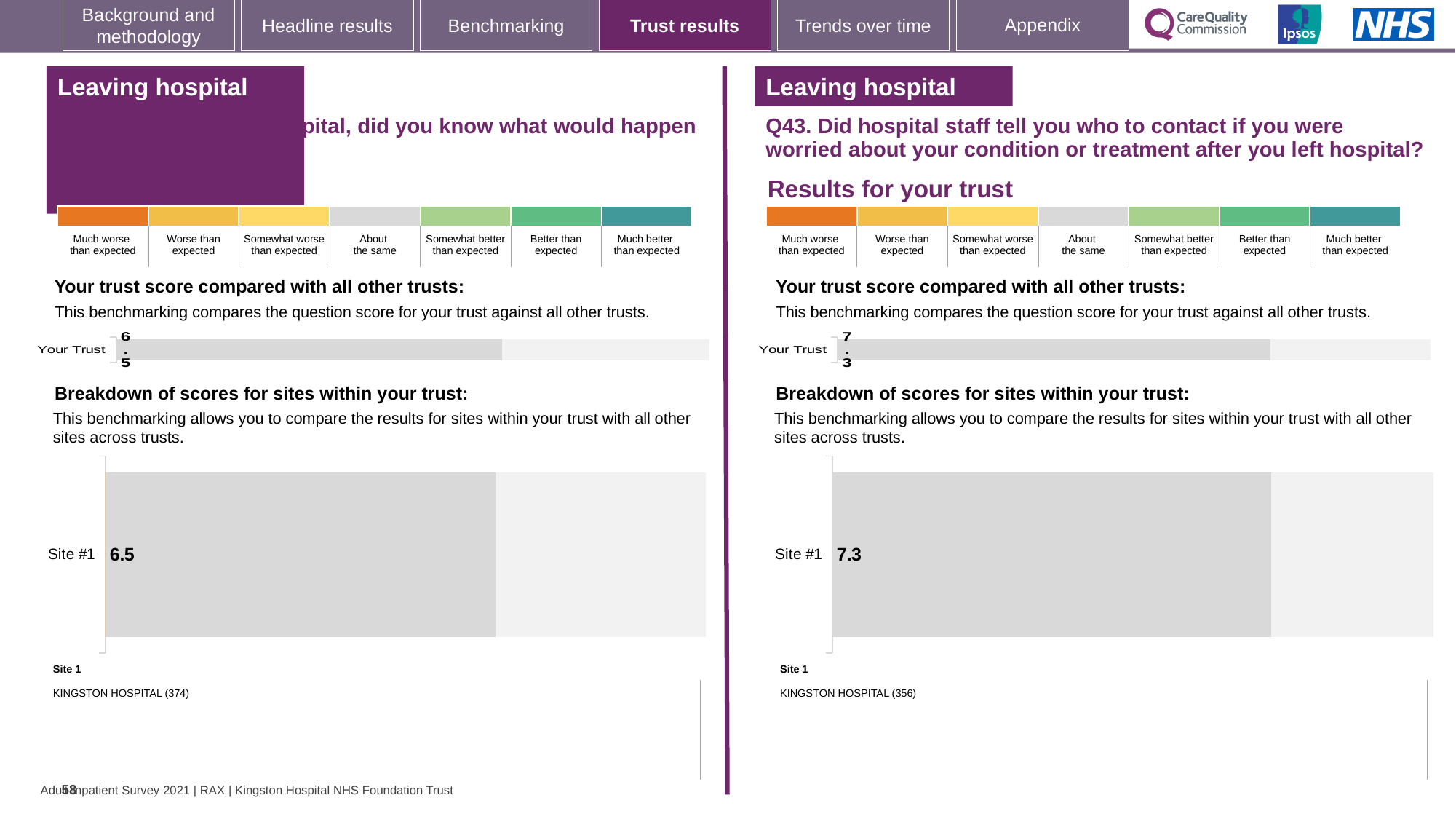
On the left half of the slide, what is the score shown for Site #1 in the 'Breakdown of scores for sites within your trust' chart? 6.5 Is the Site #1 score on the left half of the slide greater or less than 7? less Is the Site #1 score on the right half of the slide (Q43) greater or less than 7? greater On the right half of the slide (Q43), which site is listed as Site 1 below the breakdown chart? KINGSTON HOSPITAL (356) On the left half of the slide, which site is listed as Site 1 below the breakdown chart? KINGSTON HOSPITAL (374) On the right half of the slide (Q43), what is the score shown for Your Trust in the 'Your trust score compared with all other trusts' chart? 7.3 On the right half of the slide (Q43), what is the score shown for Site #1 in the 'Breakdown of scores for sites within your trust' chart? 7.3 On the left half of the slide, what is the score shown for Your Trust in the 'Your trust score compared with all other trusts' chart? 6.5 What kind of chart is used to show the Site #1 score on the left half of the slide? Bar chart Which is larger: the Your Trust score on the left half of the slide or the Your Trust score on the right half (Q43)? Right half (Q43) How many sites are plotted in the 'Breakdown of scores for sites within your trust' chart on the right half of the slide (Q43)? 1 What is the difference between the Site #1 score on the right half of the slide (Q43) and the Site #1 score on the left half? 0.8